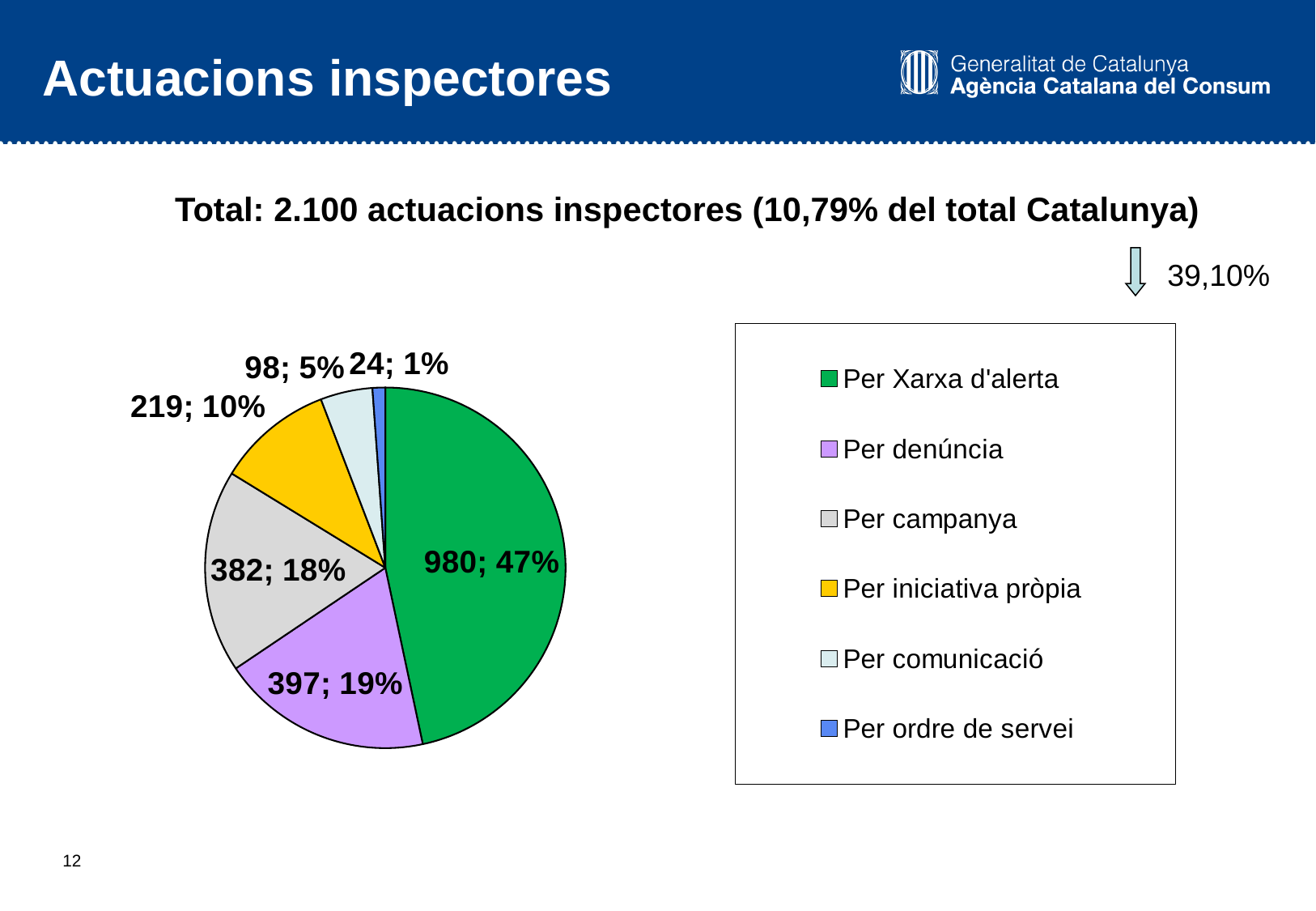
How many slices does the pie chart have? 6 Which category has the largest slice? Per Xarxa d'alerta What kind of chart is shown on the slide? pie chart What is the value for Per ordre de servei? 24 What is the difference between the values for Per Xarxa d'alerta and Per denúncia? 583 What is the value for Per iniciativa pròpia? 219 What is the value for Per Xarxa d'alerta? 980 Which is larger, the value for Per denúncia or the value for Per campanya? Per denúncia How many entries does the legend list? 6 What share of the pie does Per comunicació represent? 5% What share of the pie does Per denúncia represent? 19% Which category has the smallest slice? Per ordre de servei